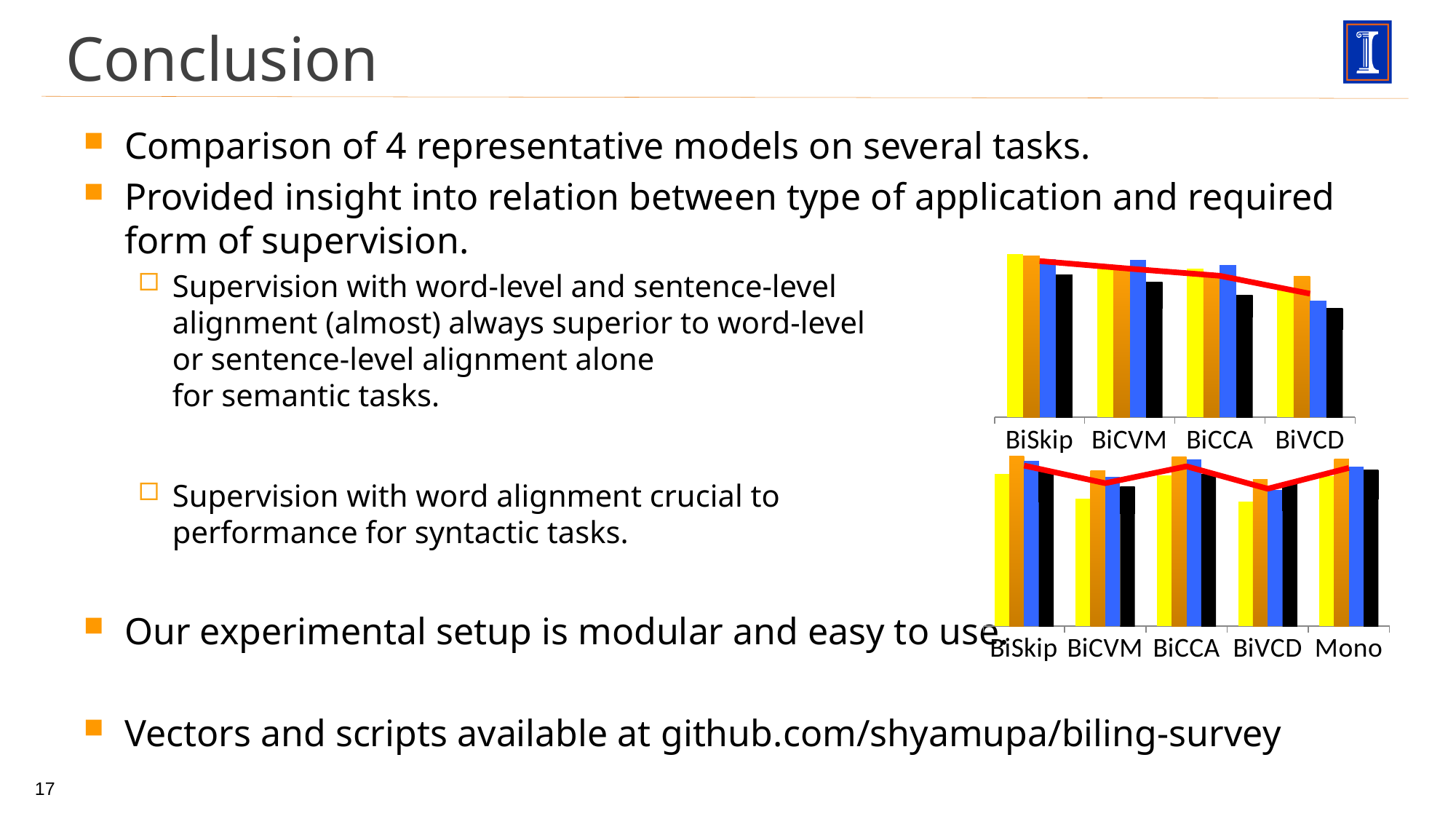
In the lower chart, is the yellow bar for BiSkip taller or shorter than the yellow bar for BiCVM? taller In the upper chart, does the red line rise or fall from BiSkip to BiVCD? fall In the upper chart, which category has the tallest yellow bar? BiSkip What kind of chart is the lower chart on the right of the slide? combination bar and line chart In the lower chart, is the yellow bar for BiCCA taller or shorter than the yellow bar for BiVCD? taller How many categories are shown on the x axis of the lower chart? 5 In the upper chart, which category has the shortest black bar? BiVCD How many categories are shown on the x axis of the upper chart? 4 What kind of chart is the upper chart on the right of the slide? combination bar and line chart Which category appears in the lower chart but not in the upper chart? Mono How many bars are drawn for each category in the upper chart? 4